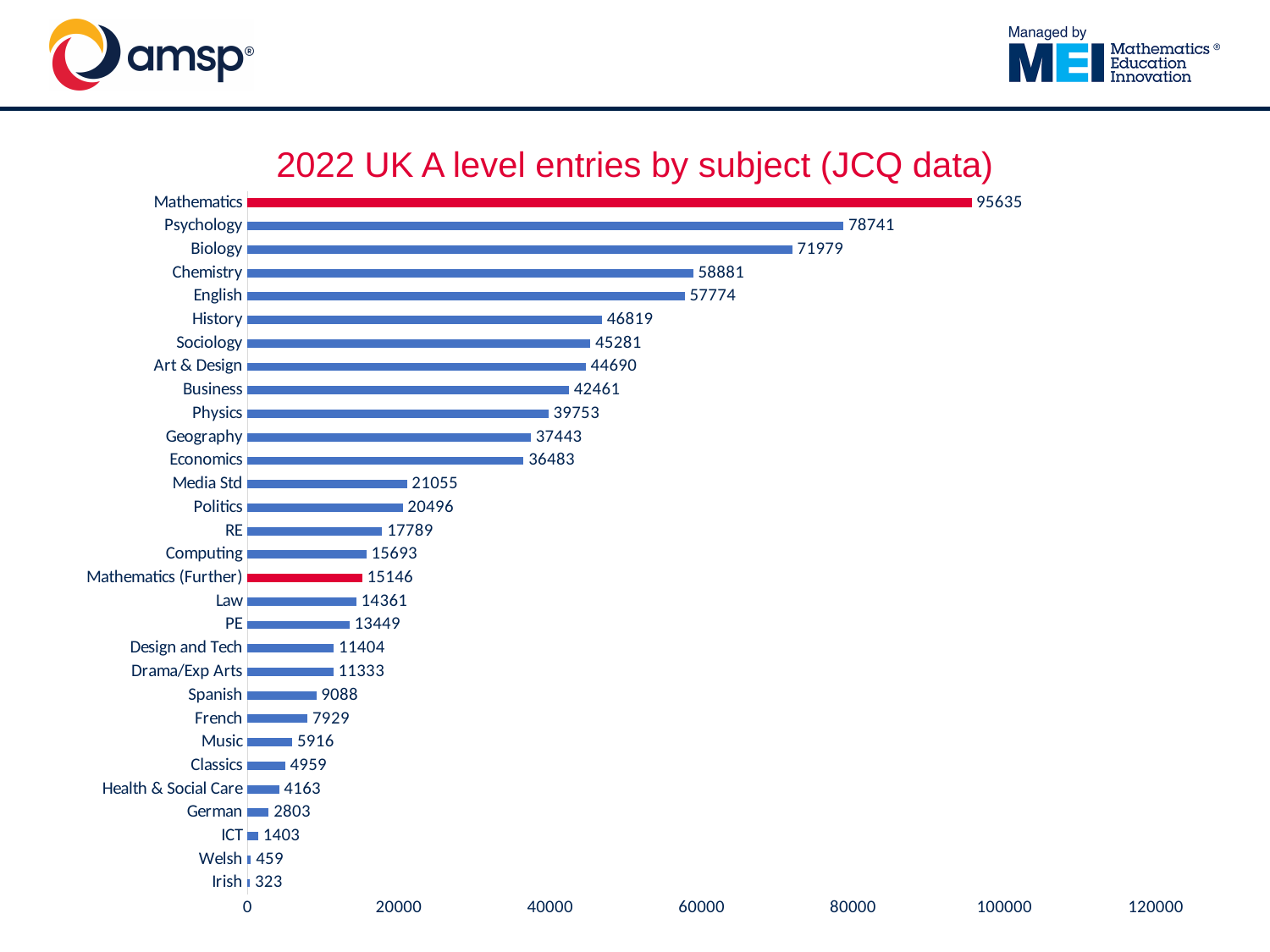
What kind of chart is shown on the slide? Bar chart What is the number of entries for Physics? 39753 How many subjects are shown in the chart? 30 What is the number of entries for Mathematics (Further)? 15146 Which has more entries, Chemistry or English? Chemistry Which subject has the lowest number of entries? Irish What is the number of entries for Mathematics? 95635 Which subject has the highest number of entries? Mathematics What is the difference in entries between Mathematics and Mathematics (Further)? 80489 Is the value for Biology greater or less than 60000? greater What is the difference in entries between Mathematics and Psychology? 16894 What is the title of the chart? 2022 UK A level entries by subject (JCQ data)